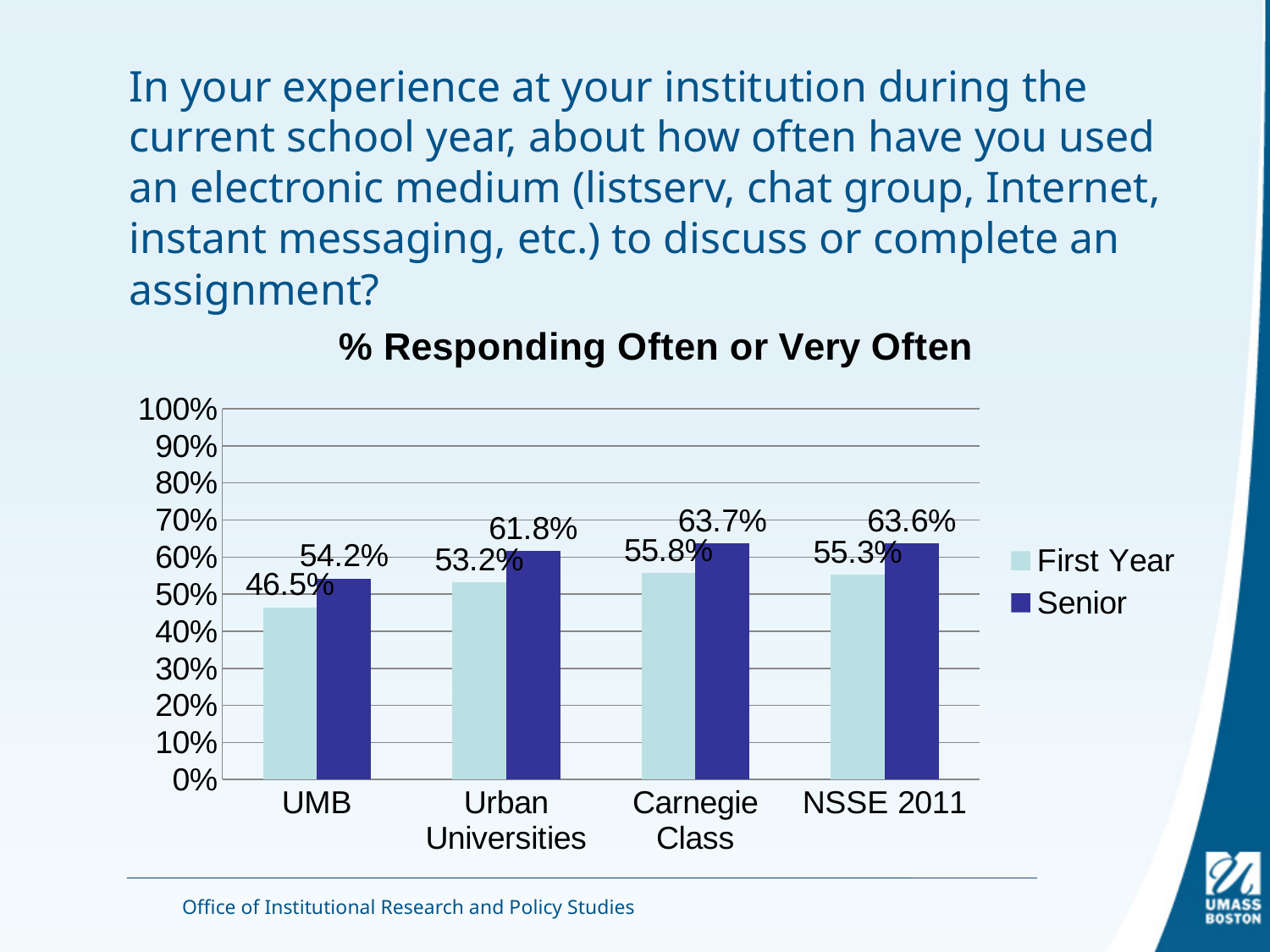
What is the difference between the Senior and First Year values for Urban Universities? 8.6 percentage points Which category has the lowest Senior value? UMB What is the First Year value for NSSE 2011? 55.3% Is the First Year value for UMB greater or less than 50%? less What is the First Year value for UMB? 46.5% Which is larger for Carnegie Class, the First Year value or the Senior value? Senior How many series does the legend list? 2 Which category has the lowest First Year value? UMB What is the difference between the Senior and First Year values for UMB? 7.7 percentage points What is the Senior value for Urban Universities? 61.8% What is the Senior value for Carnegie Class? 63.7% How many categories are shown on the x axis? 4